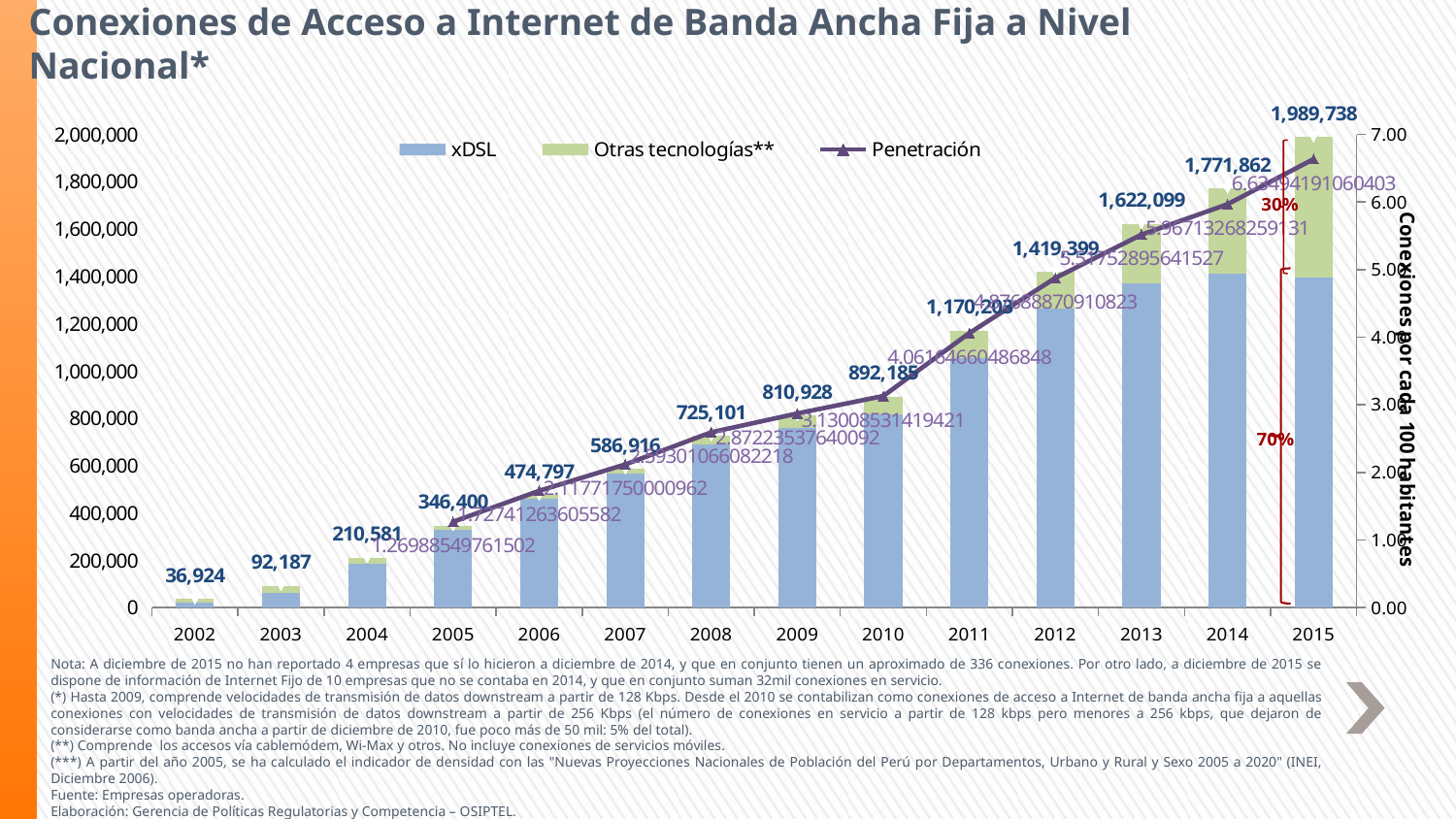
Which year has more total connections, 2011 or 2012? 2012 Which year has the highest total number of connections? 2015 What is the total number of connections shown for 2002? 36,924 Which year has the lowest total number of connections? 2002 What is the total number of connections shown for 2010? 892,185 Is the xDSL value for 2015 greater or less than 1,200,000? greater Do the total connections rise or fall from 2002 to 2015? Rise What is the total number of connections shown for 2007? 586,916 What is the total number of fixed broadband connections shown for 2015? 1,989,738 How many series does the legend list? 3 What is the difference between the total connections in 2015 and in 2014? 217,876 How many years are shown on the x axis? 14